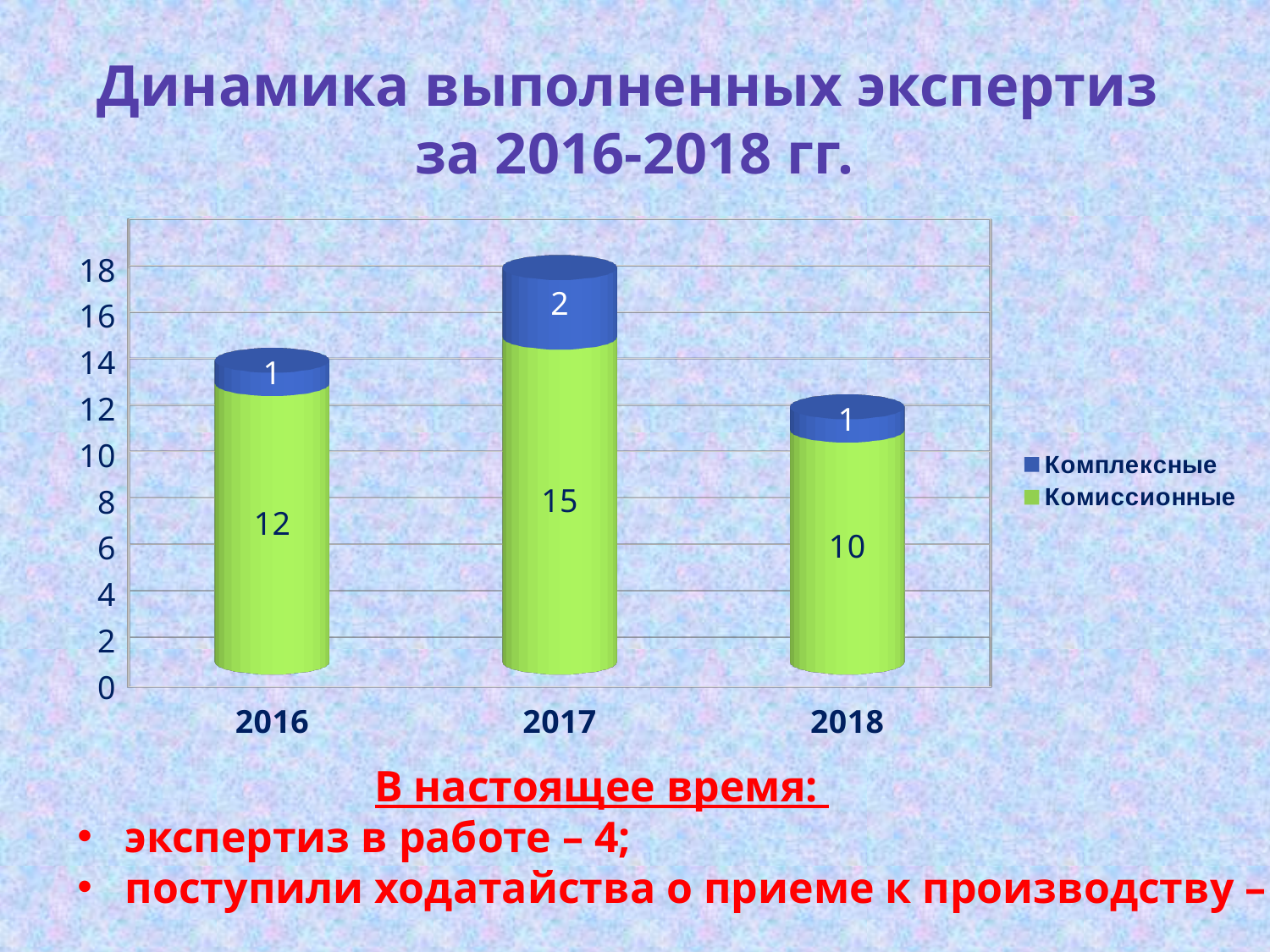
Which year has the highest value for Комиссионные? 2017 Which is larger, the Комиссионные value for 2016 or for 2018? 2016 How many years are shown on the x axis? 3 What is the value for Комиссионные in 2017? 15 Which year has the lowest value for Комиссионные? 2018 How many series does the legend list? 2 What is the value for Комиссионные in 2018? 10 What is the value for Комплексные in 2017? 2 What is the difference between the Комиссионные values for 2017 and 2018? 5 What is the total of the stacked bar for 2017? 17 What is the total of the stacked bar for 2016? 13 What is the value for Комплексные in 2016? 1